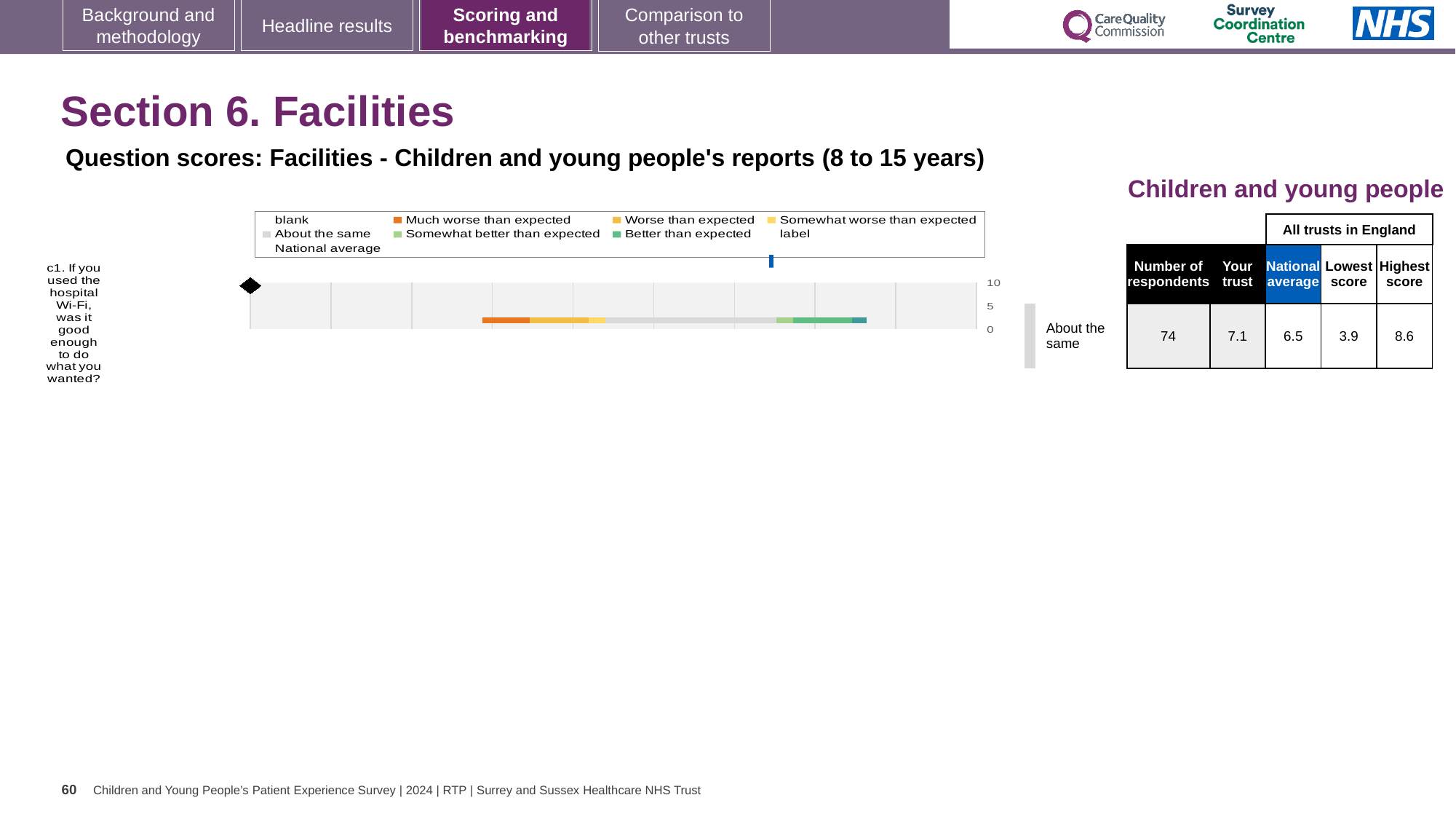
What rating category is given for question c1 about the hospital Wi-Fi? About the same How many respondents answered question c1 about the hospital Wi-Fi? 74 Which colour does the legend use for 'Much worse than expected'? orange How many survey questions are plotted on the chart? 1 What is the highest value shown on the chart's axis? 10 What is the difference between the highest score and the lowest score among all trusts in England for question c1? 4.7 What is the 'Your trust' score for question c1 about the hospital Wi-Fi? 7.1 What is the lowest score among all trusts in England for question c1? 3.9 What kind of chart is shown on the slide? bar chart What is the national average score for question c1 about the hospital Wi-Fi? 6.5 What is the highest score among all trusts in England for question c1? 8.6 Which is larger for question c1: the 'Your trust' score or the national average? Your trust